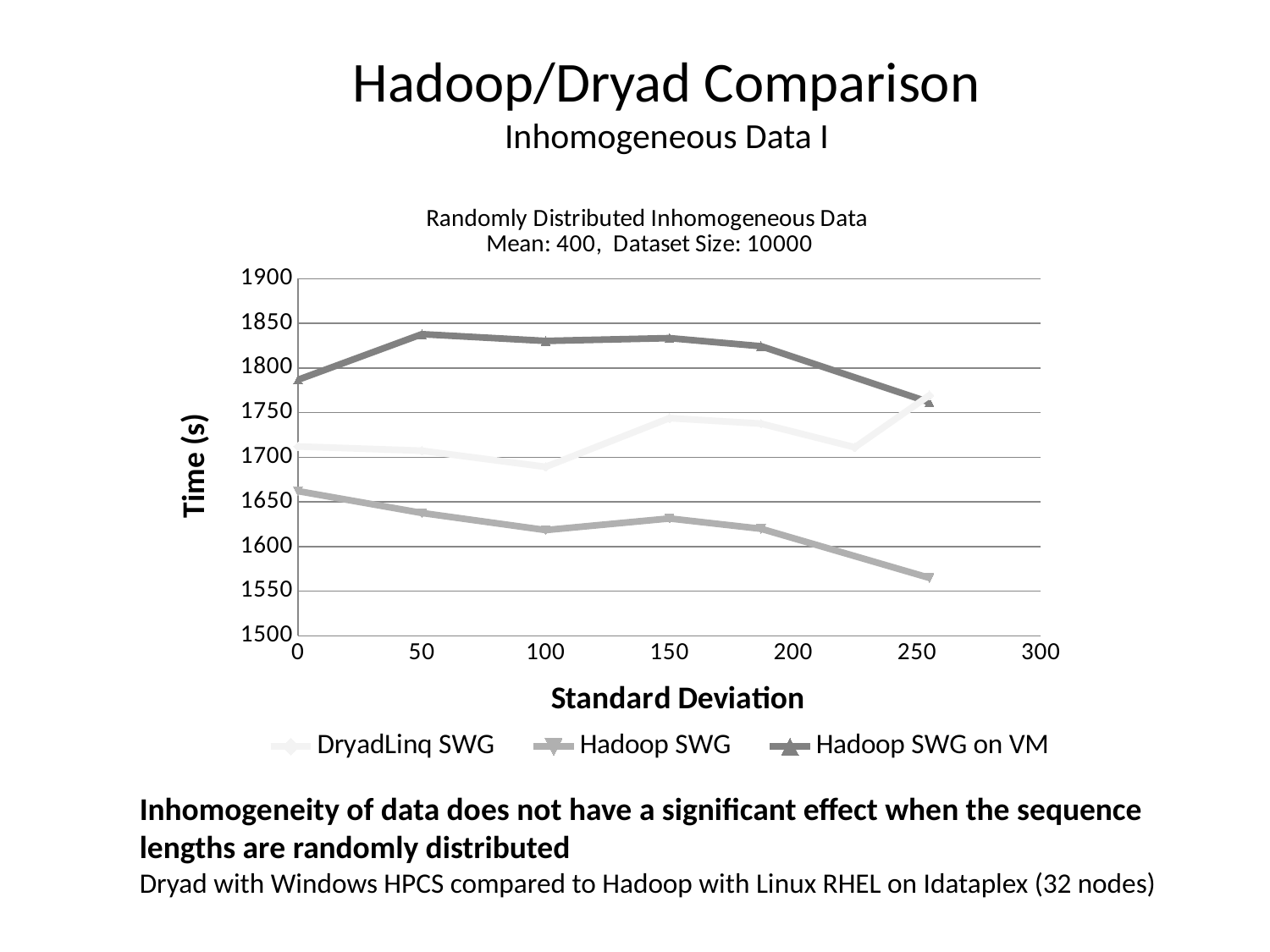
Is the value for Hadoop SWG on VM at standard deviation 50 greater or less than 1800? greater Is the value for Hadoop SWG at standard deviation 250 greater or less than 1600? less What is the title of the chart? Randomly Distributed Inhomogeneous Data Mean: 400, Dataset Size: 10000 Is the value for Hadoop SWG at standard deviation 100 greater or less than 1650? less Which series has the lowest values across the chart? Hadoop SWG Does the Hadoop SWG line rise or fall overall as standard deviation increases? Fall What kind of chart is shown on the slide? Line chart How many series does the legend list? 3 What is the label of the y axis? Time (s) At standard deviation 100, which is larger: DryadLinq SWG or Hadoop SWG? DryadLinq SWG Which series has the highest values across the chart? Hadoop SWG on VM